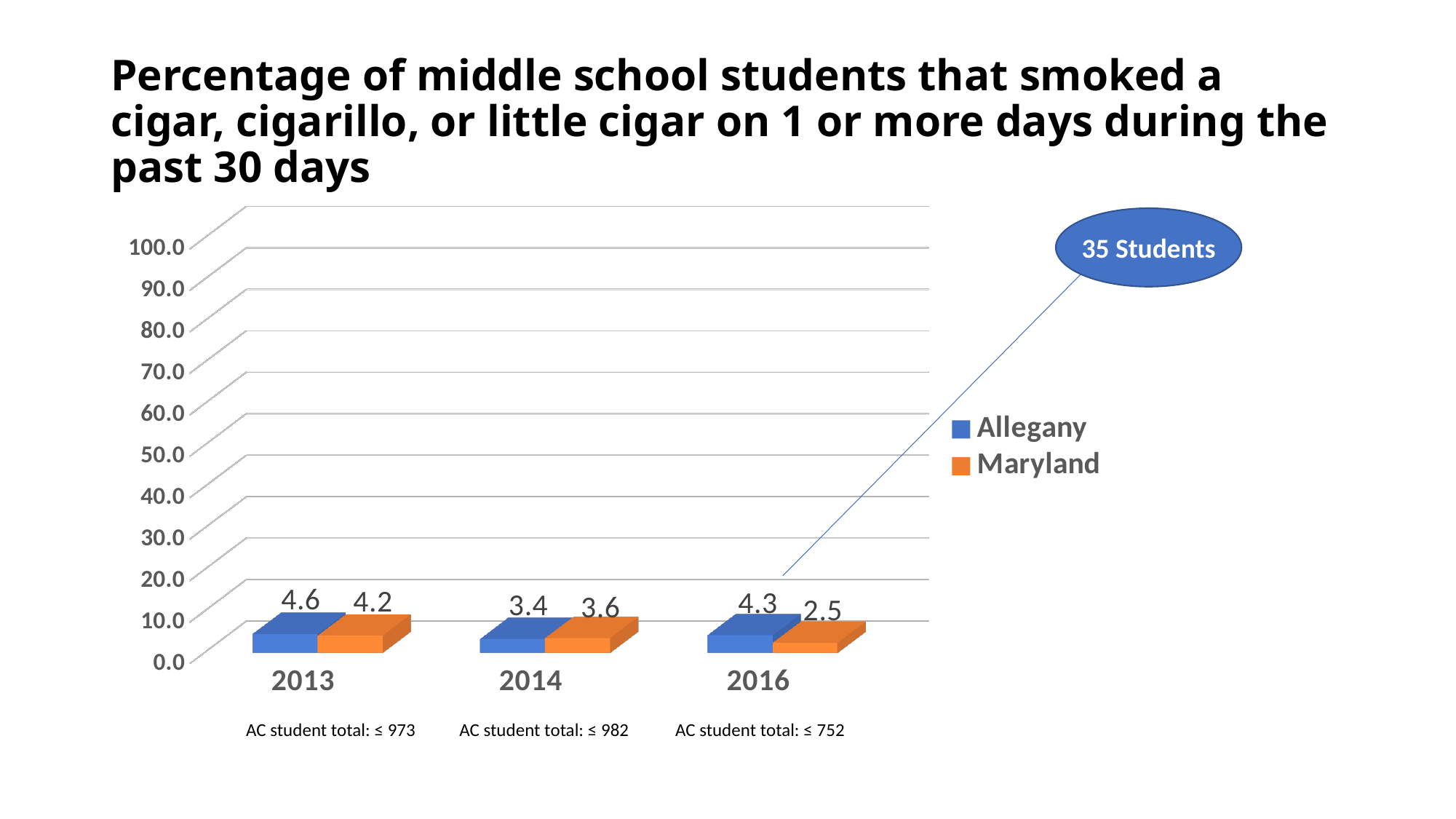
What is the difference between the Allegany and Maryland values in 2016? 1.8 How many series does the legend list? 2 What kind of chart is shown on the slide? bar chart Is the value for Allegany in 2016 greater or less than 10.0? less In which year is the Maryland value highest? 2013 How many years are shown on the x axis? 3 What is the value for Maryland in 2014? 3.6 Which is larger in 2014, the Allegany value or the Maryland value? Maryland What is the value for Maryland in 2016? 2.5 In which year is the Allegany value lowest? 2014 What is the value for Allegany in 2013? 4.6 Does the Maryland value rise or fall from 2013 to 2016? fall